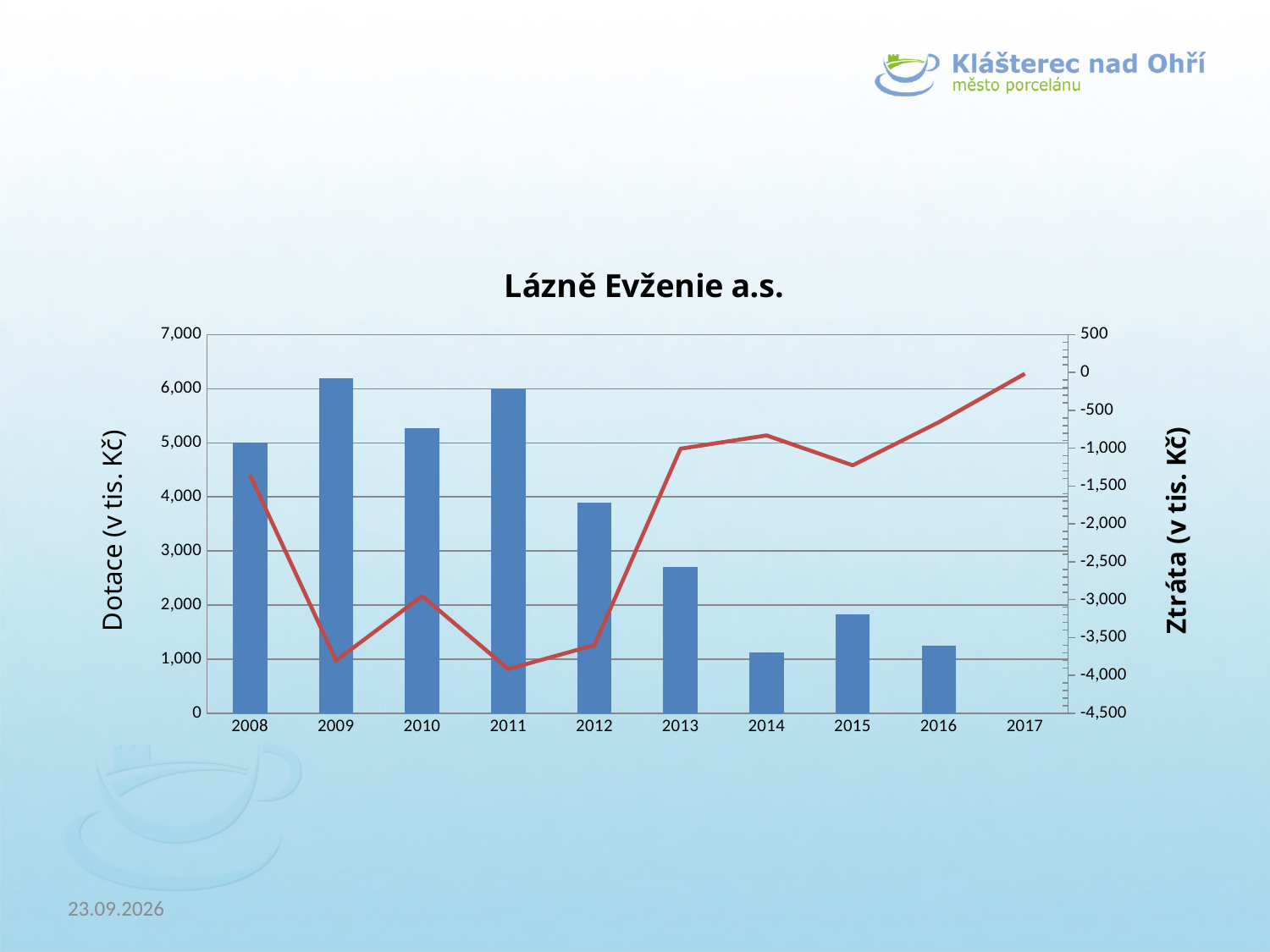
Which is larger, the Dotace bar for 2015 or for 2016? 2015 How many years are labelled on the x axis? 10 Do the Dotace bars generally rise or fall from 2008 to 2016? fall Which is larger, the Dotace bar for 2010 or for 2013? 2010 Is the Dotace value for 2012 greater or less than 4,000? less Is the Ztráta value for 2009 greater or less than -3,500? less Is the Dotace value for 2009 greater or less than 6,000? greater What is the title of the chart? Lázně Evženie a.s. In which year does the Ztráta line reach its highest point? 2017 Which year has the highest Dotace bar? 2009 What kind of chart is shown on the slide? A combined bar and line chart